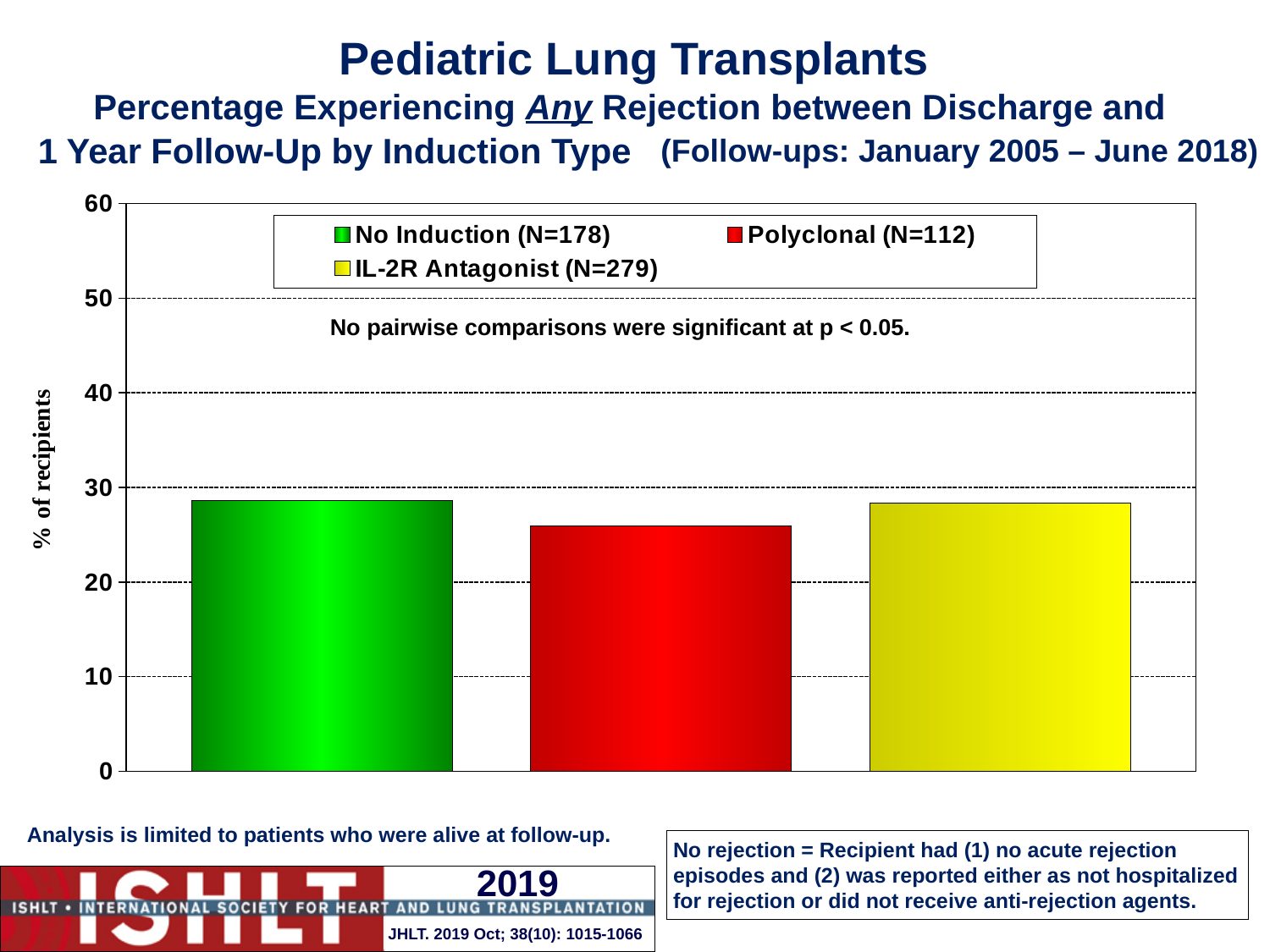
Is the value for No Induction (N=178) greater or less than 30? less Which is larger, the value for No Induction (N=178) or the value for Polyclonal (N=112)? No Induction (N=178) Which is larger, the value for IL-2R Antagonist (N=279) or the value for Polyclonal (N=112)? IL-2R Antagonist (N=279) Is the value for Polyclonal (N=112) greater or less than 20? greater Is the value for IL-2R Antagonist (N=279) greater or less than 30? less What kind of chart is shown on the slide? bar chart According to the legend, how many recipients are in the IL-2R Antagonist group? 279 What colour is the bar for Polyclonal (N=112)? red How many series does the legend list? 3 How many bars are plotted in the chart? 3 Which induction type has the lowest percentage of recipients experiencing any rejection? Polyclonal (N=112)